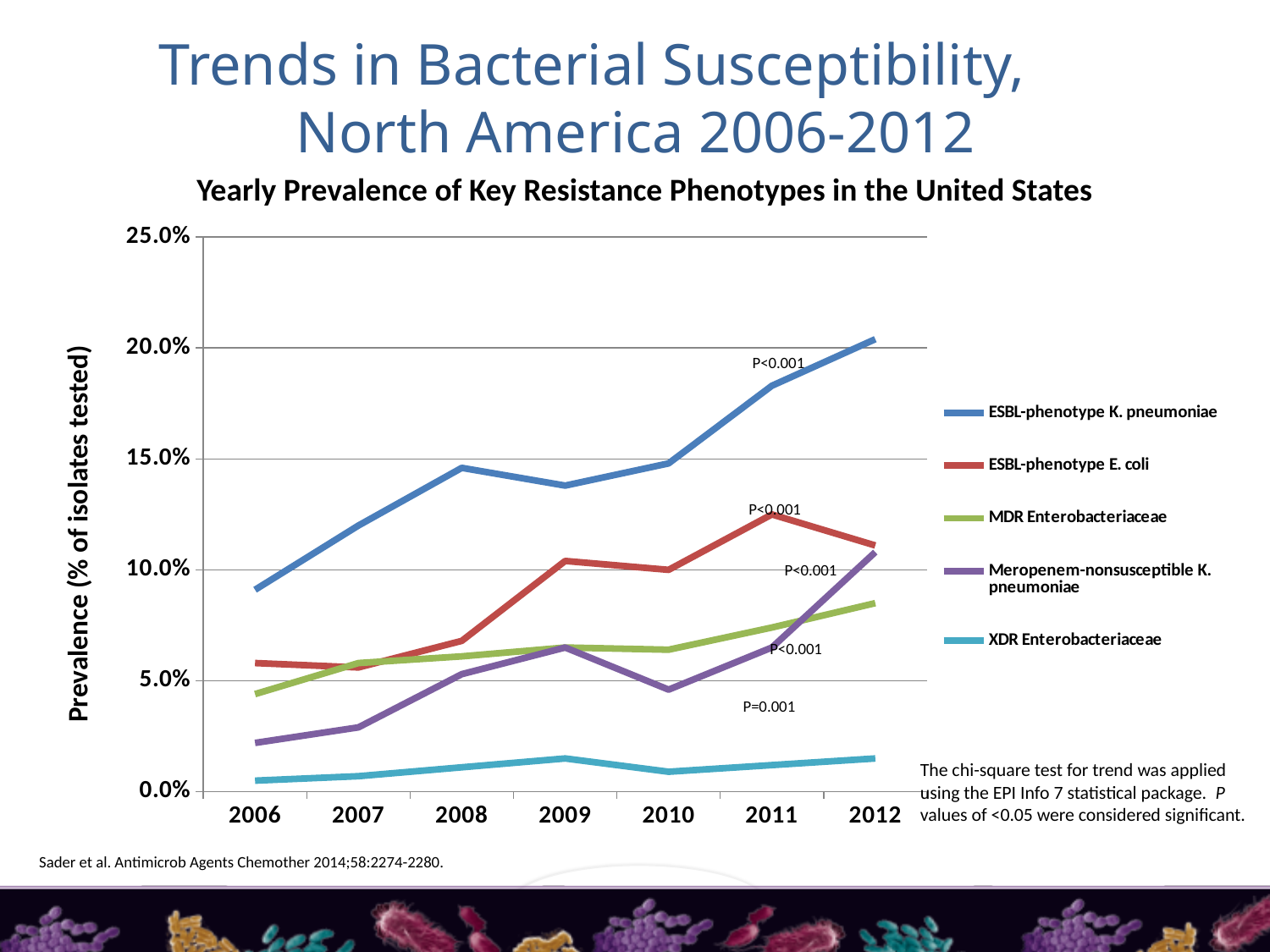
How many years are plotted along the x axis? 7 Is the value for ESBL-phenotype E. coli in 2011 greater or less than 10.0%? greater Does the ESBL-phenotype K. pneumoniae line rise or fall overall from 2006 to 2012? Rises How many series does the legend list? 5 Is the value for XDR Enterobacteriaceae in 2009 greater or less than 5.0%? less Which series has the lowest value in 2012? XDR Enterobacteriaceae What is the label of the y axis? Prevalence (% of isolates tested) Is the value for ESBL-phenotype K. pneumoniae in 2011 greater or less than 15.0%? greater Which series has the highest value in 2012? ESBL-phenotype K. pneumoniae In 2010, which is larger: ESBL-phenotype E. coli or MDR Enterobacteriaceae? ESBL-phenotype E. coli What is the title of the chart? Yearly Prevalence of Key Resistance Phenotypes in the United States What kind of chart is shown on the slide? Line chart